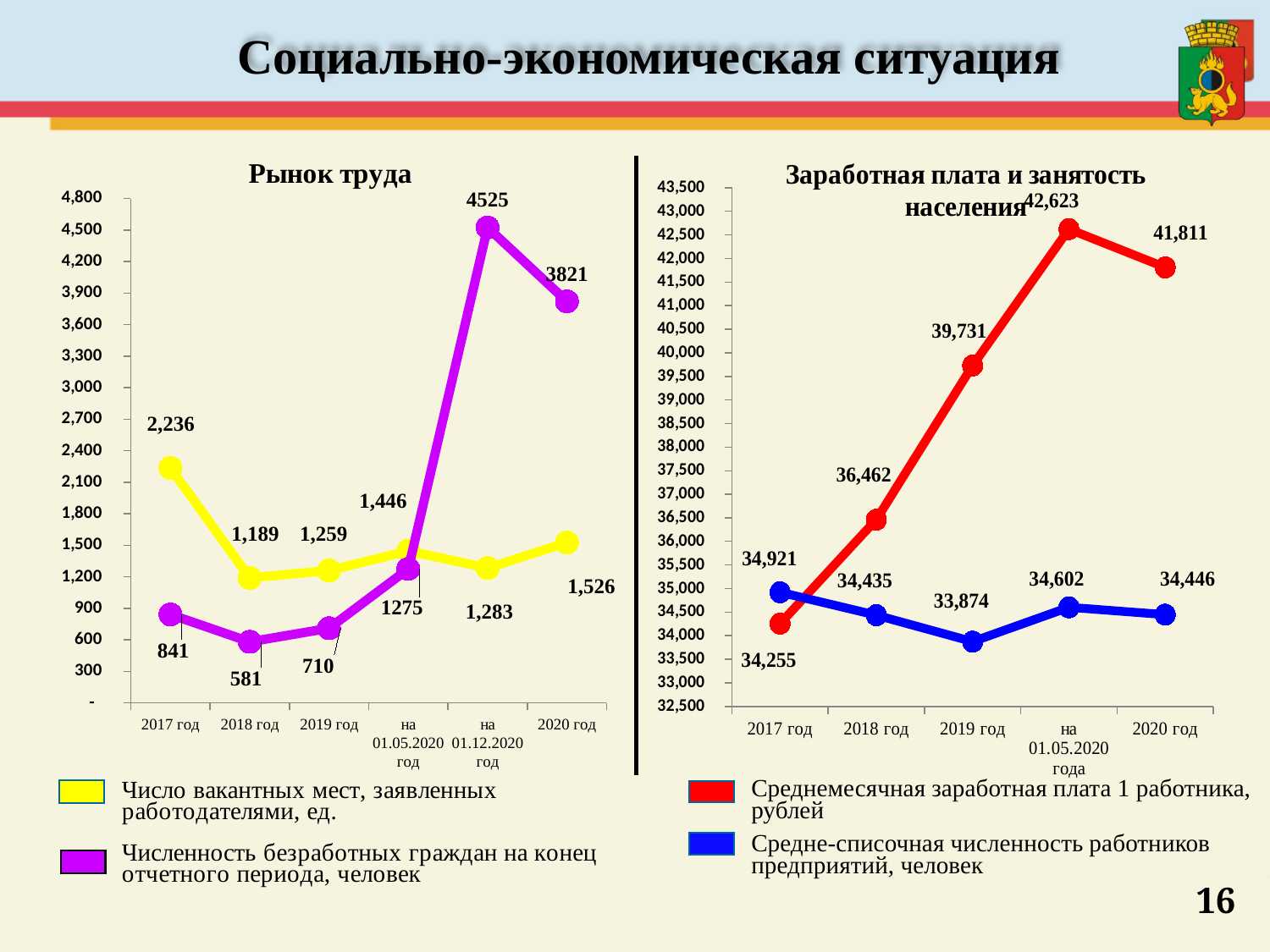
On the 'Рынок труда' chart, what is the difference between the number of unemployed citizens at на 01.12.2020 год and in 2020 год? 704 On the 'Рынок труда' chart, which is larger in 2019 год: the number of vacancies or the number of unemployed citizens? Number of vacancies (1,259) On the 'Рынок труда' chart, in which period is the number of unemployed citizens lowest? 2018 год On the 'Рынок труда' chart, what is the number of unemployed citizens (purple series) at на 01.12.2020 год? 4525 On the 'Заработная плата и занятость населения' chart, in which period is the average monthly salary highest? на 01.05.2020 года How many series does the legend of the 'Заработная плата и занятость населения' chart list? 2 On the 'Заработная плата и занятость населения' chart, what is the difference between the average salary in 2018 год and 2017 год? 2,207 What type of chart is 'Заработная плата и занятость населения'? Line chart How many periods are shown on the x axis of the 'Рынок труда' chart? 6 On the 'Заработная плата и занятость населения' chart, what is the average monthly salary (red series) in 2019 год? 39,731 On the 'Рынок труда' chart, what is the number of vacancies (yellow series) in 2017 год? 2,236 On the 'Заработная плата и занятость населения' chart, in which period is the average headcount of employees (blue series) lowest? 2019 год